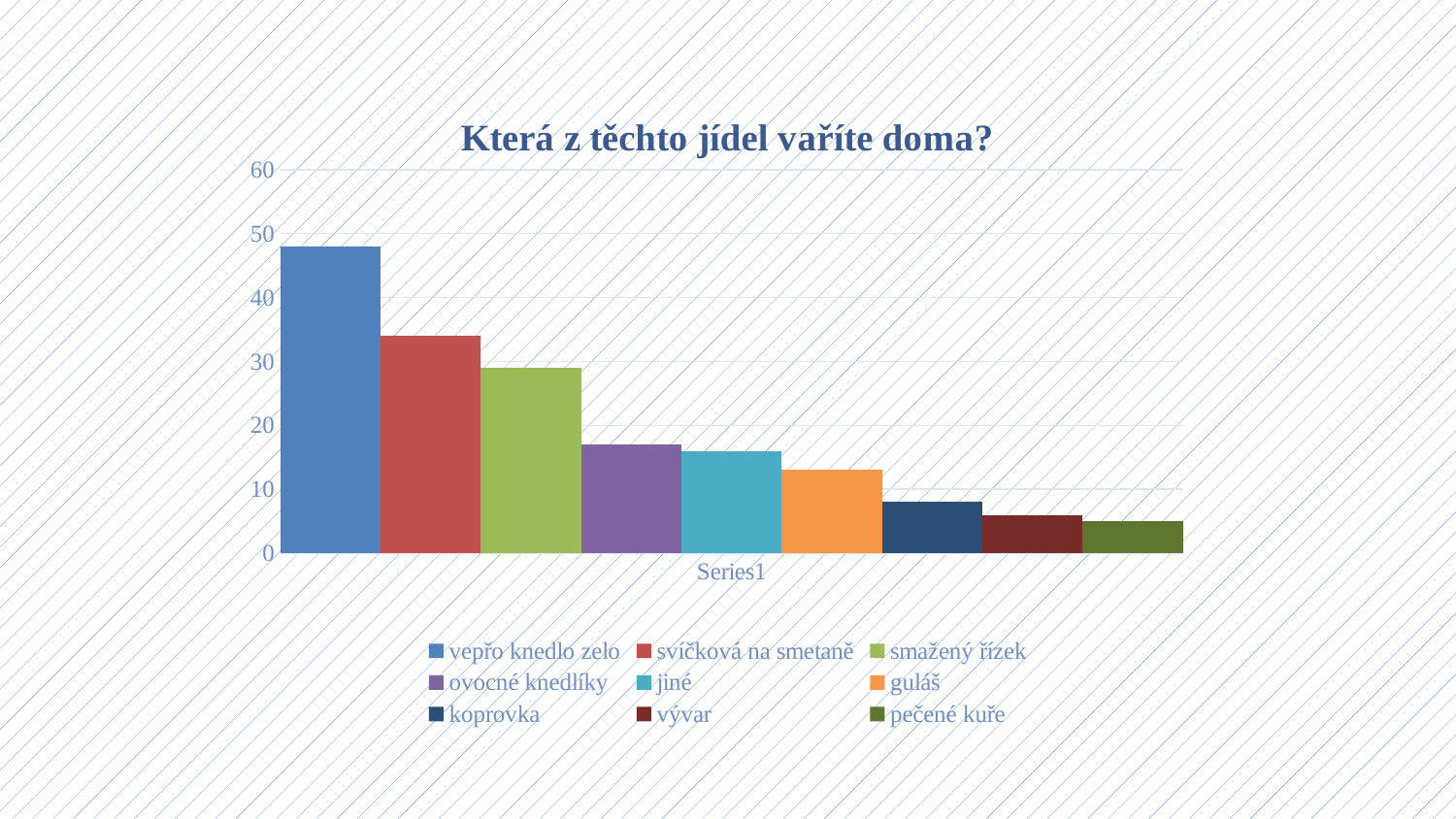
Is the value for vepřo knedlo zelo greater or less than 40? greater Which is larger, the value for guláš or the value for jiné? jiné Is the value for ovocné knedlíky greater or less than 20? less How many entries does the legend list? 9 Which dish has the highest bar? vepřo knedlo zelo What is the title of the chart? Která z těchto jídel vaříte doma? Is the value for svíčková na smetaně greater or less than 30? greater Which dish has the lowest bar? pečené kuře Which is larger, the value for koprovka or the value for vývar? koprovka What type of chart is shown on the slide? bar chart How many bars are plotted in the chart? 9